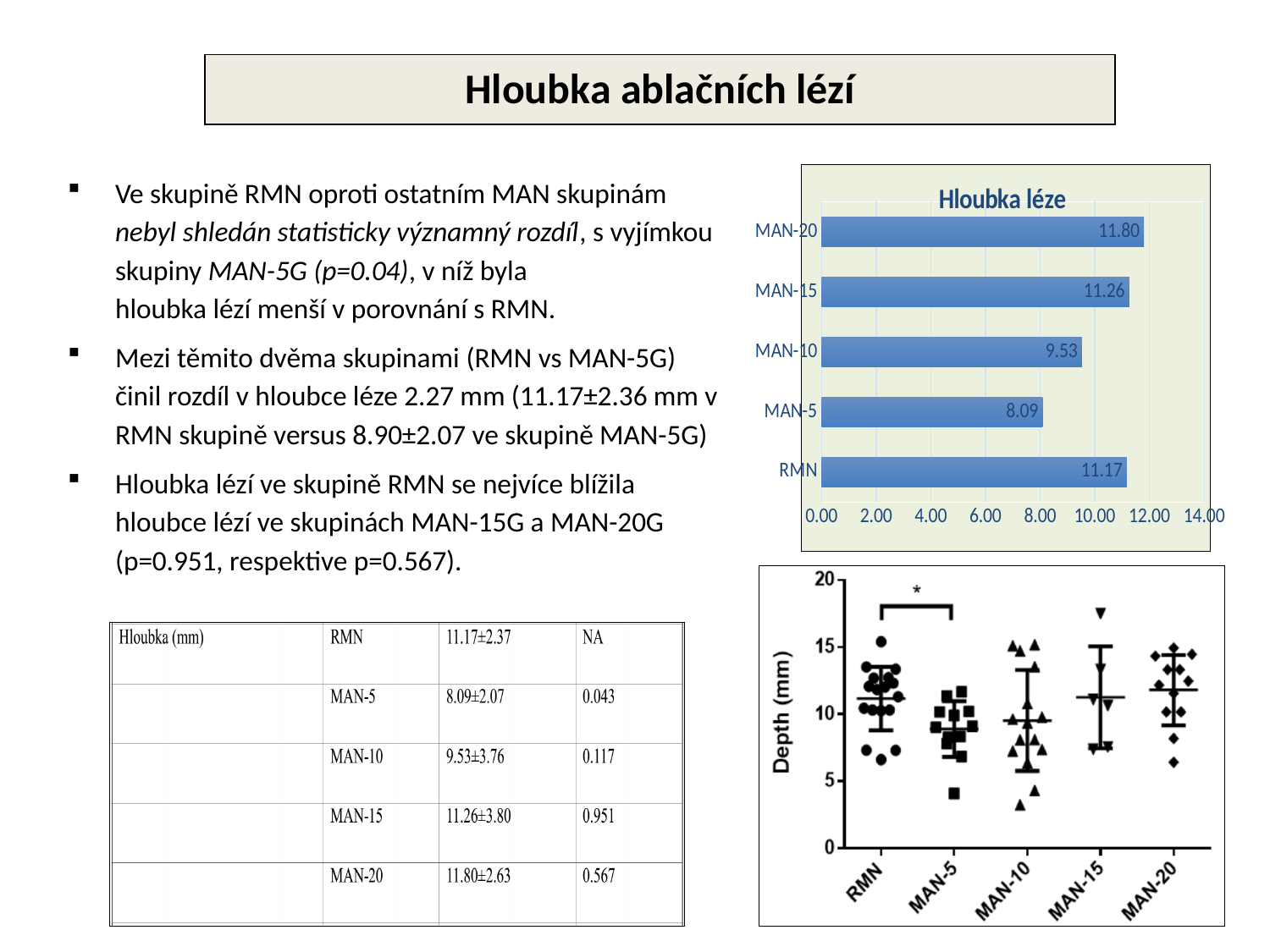
In the 'Hloubka léze' bar chart, is the value for MAN-10 greater or less than 10.00? less In the 'Hloubka léze' bar chart, what is the value for RMN? 11.17 In the 'Hloubka léze' bar chart, which is larger, the value for MAN-10 or the value for MAN-5? MAN-10 What is the y-axis label of the dot plot at the bottom right of the slide? Depth (mm) In the 'Hloubka léze' bar chart, what is the difference between the values for RMN and MAN-5? 3.08 In the 'Hloubka léze' bar chart, what is the value for MAN-20? 11.80 In the 'Hloubka léze' bar chart, what is the value for MAN-5? 8.09 In the 'Hloubka léze' bar chart, what is the difference between the values for MAN-15 and MAN-10? 1.73 In the 'Hloubka léze' bar chart, which category has the highest value? MAN-20 What kind of chart is the 'Hloubka léze' chart on the upper right of the slide? bar chart How many categories are shown in the 'Hloubka léze' bar chart? 5 In the 'Hloubka léze' bar chart, which category has the lowest value? MAN-5